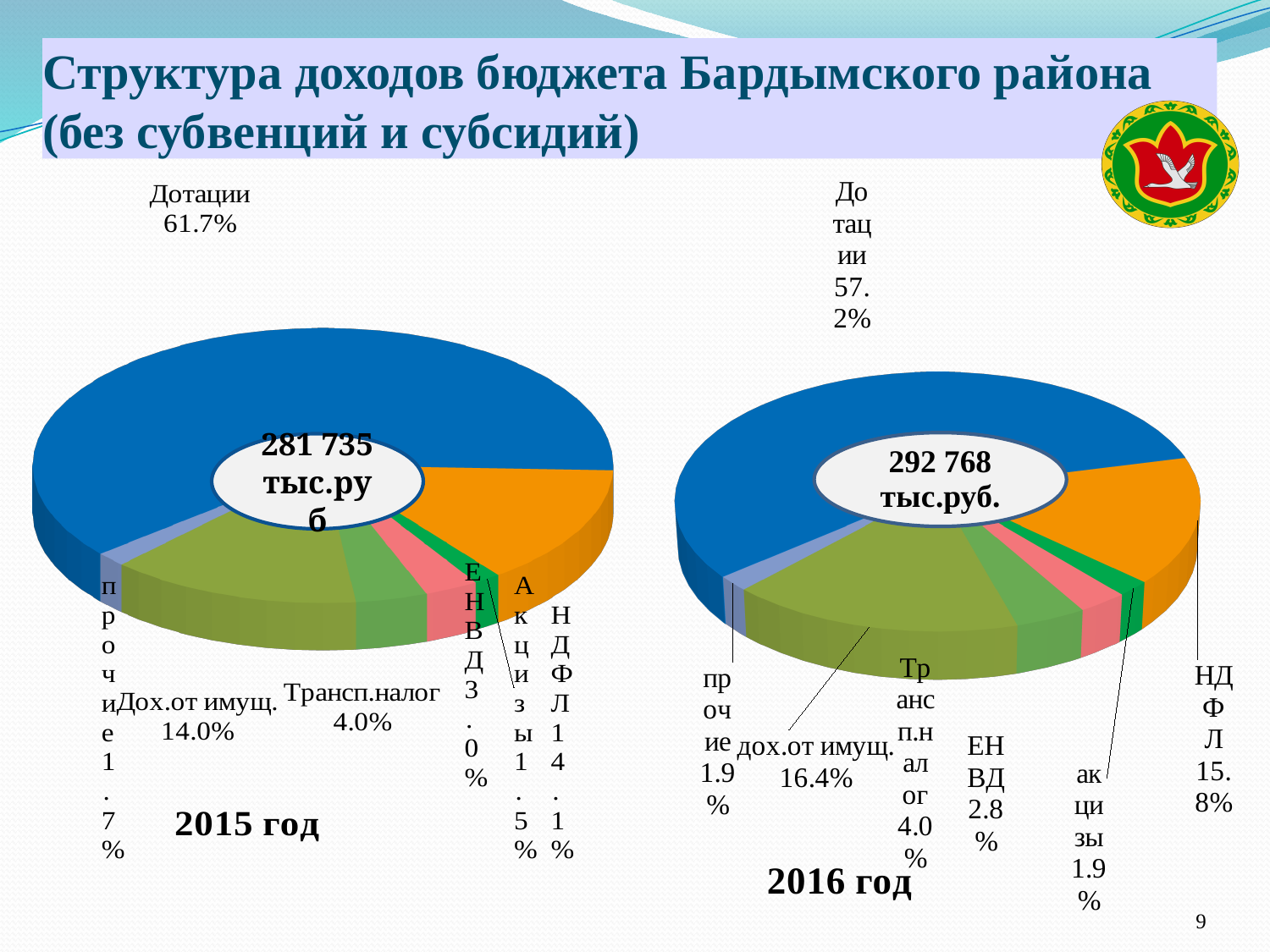
What is the difference between the Дотации share in 2015 год and in 2016 год? 4.5% What total amount is shown in the centre of the 2016 год pie chart? 292 768 тыс.руб. In the 2016 год pie chart, what is the share of ЕНВД? 2.8% What type of chart is used on this slide? Pie chart In the 2016 год pie chart, what share do Дотации have? 57.2% In the 2015 год pie chart, what share do Дотации have? 61.7% In the 2015 год pie chart, what is the share of Дох.от имущ.? 14.0% How many categories are shown in the 2016 год pie chart? 7 In the 2016 год pie chart, which is larger: дох.от имущ. or НДФЛ? дох.от имущ. In the 2015 год pie chart, which category has the largest share? Дотации In the 2015 год pie chart, which category has the smallest share? Акцизы In the 2016 год pie chart, what is the share of НДФЛ? 15.8%